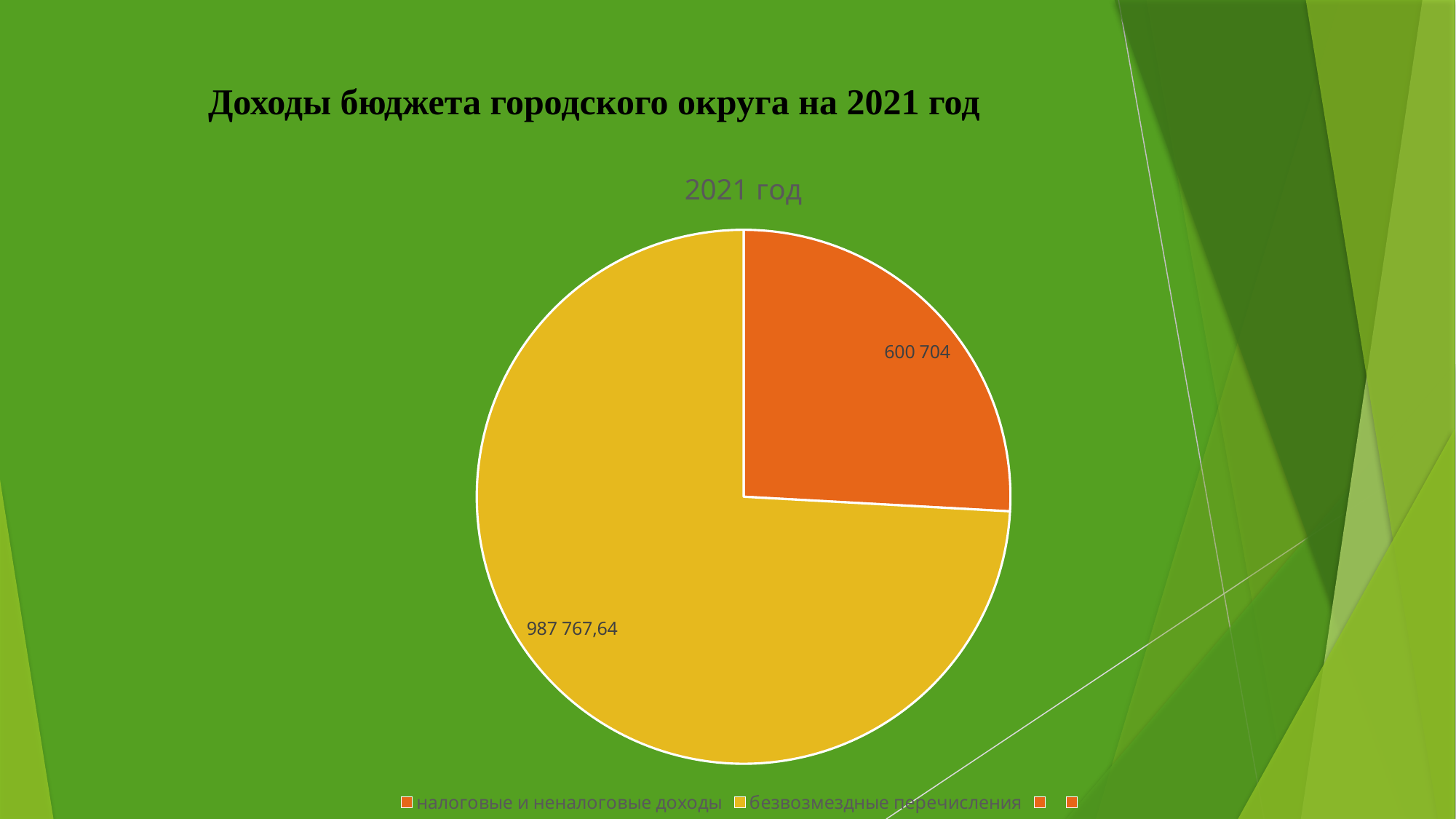
What kind of chart is shown on the slide? pie chart Which category has the smallest slice in the pie chart? налоговые и неналоговые доходы What colour is the slice for налоговые и неналоговые доходы? orange What is the total of the two slices shown in the pie chart? 1 588 471,64 What is the title of the chart? 2021 год What is the difference between безвозмездные перечисления and налоговые и неналоговые доходы? 387 063,64 Which category has the largest slice in the pie chart? безвозмездные перечисления Which is larger: налоговые и неналоговые доходы or безвозмездные перечисления? безвозмездные перечисления What is the value for безвозмездные перечисления in the pie chart? 987 767,64 How many labelled slices does the pie chart have? 2 What is the value for налоговые и неналоговые доходы in the pie chart? 600 704